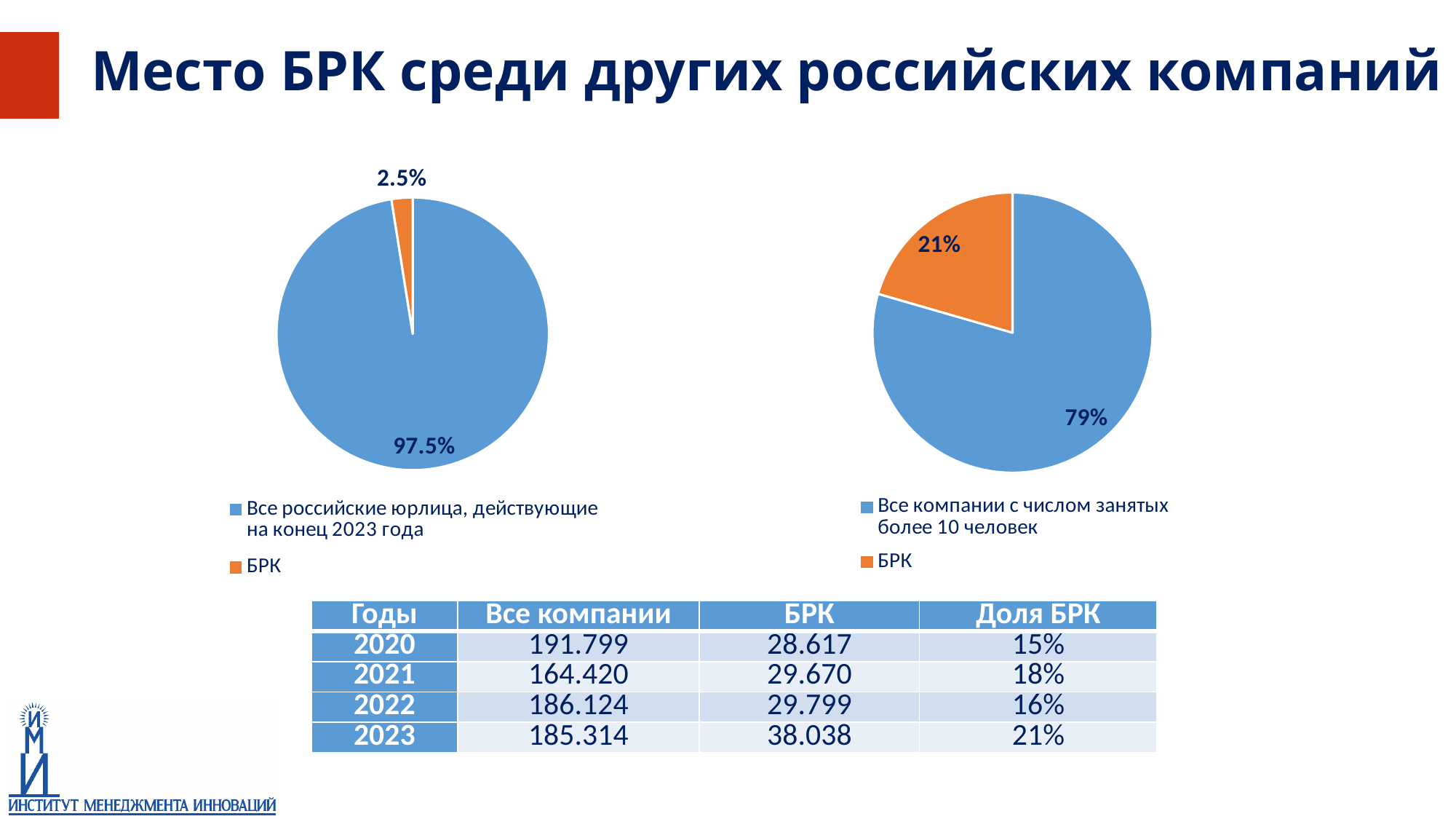
In the right pie chart, what is the difference between the share of "Все компании с числом занятых более 10 человек" and the share of БРК? 58% What colour is the БРК slice in both pie charts? orange In the left pie chart, which slice is the largest? Все российские юрлица, действующие на конец 2023 года In the right pie chart, which slice is the smallest? БРК Is the БРК share larger in the left pie chart or in the right pie chart? right pie chart What kind of chart is the left chart on the slide? pie chart In the right pie chart, what share do "Все компании с числом занятых более 10 человек" have? 79% In the left pie chart, what share do "Все российские юрлица, действующие на конец 2023 года" have? 97.5% In the right pie chart, what share does БРК have? 21% How many slices does the right pie chart have? 2 How many entries does the legend of the left pie chart list? 2